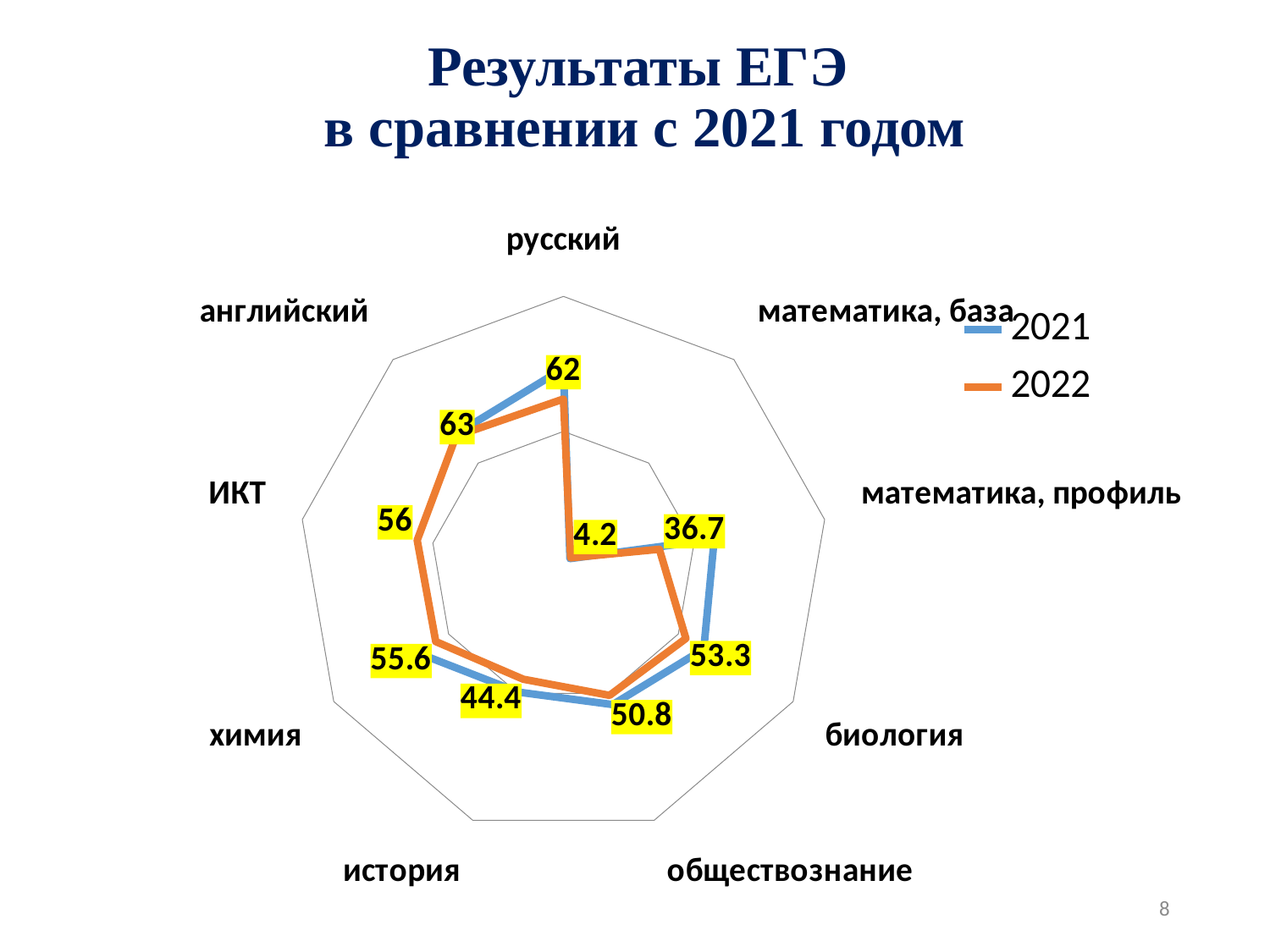
For русский, which series has the higher value, 2021 or 2022? 2021 Which subject has the highest labelled value? английский What value is labelled at the история point? 44.4 What value is labelled at the биология point? 53.3 How many series does the legend list? 2 Which subject has the lowest labelled value? математика, база How many subjects (categories) are plotted on the radar chart? 9 What value is labelled at the математика, база point? 4.2 Which colour represents the 2022 series in the legend? Orange For ИКТ, which series has the higher value, 2021 or 2022? 2022 What kind of chart is shown on the slide? Radar chart What is the difference between the labelled values for биология and обществознание? 2.5